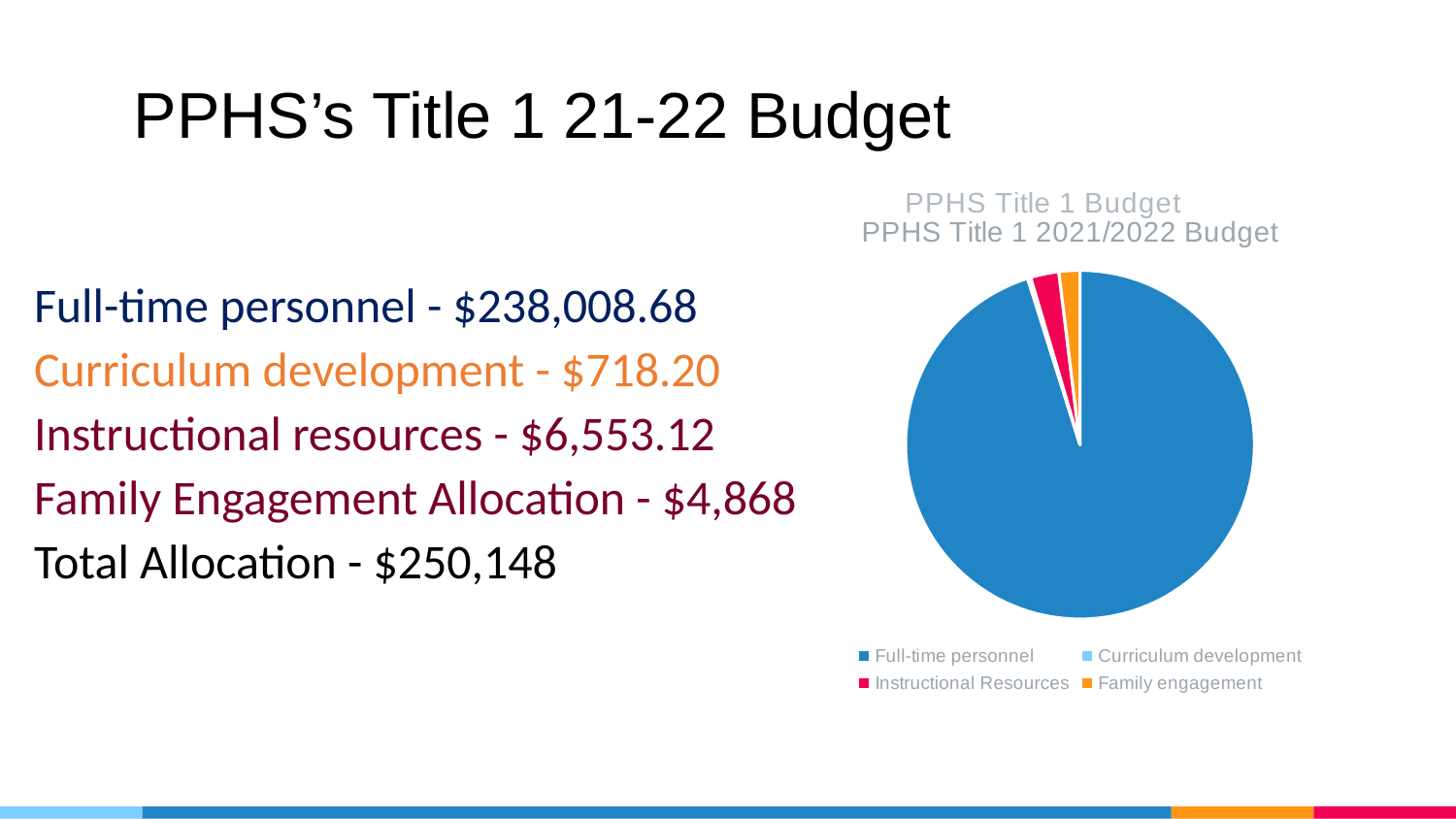
What colour is the Full-time personnel slice in the pie chart? blue What kind of chart is shown on the slide? pie chart According to the slide, what is the amount for Curriculum development? $718.20 How many slices does the pie chart have? 4 What is the total allocation shown on the slide? $250,148 According to the slide, what is the amount for Instructional resources? $6,553.12 Which category takes up the smallest slice of the pie chart? Curriculum development Which category takes up the largest slice of the pie chart? Full-time personnel According to the slide, what is the amount for Full-time personnel? $238,008.68 According to the slide, what is the Family Engagement Allocation? $4,868 Which slice is larger in the pie chart: Instructional Resources or Family engagement? Instructional Resources How many entries does the pie chart's legend list? 4